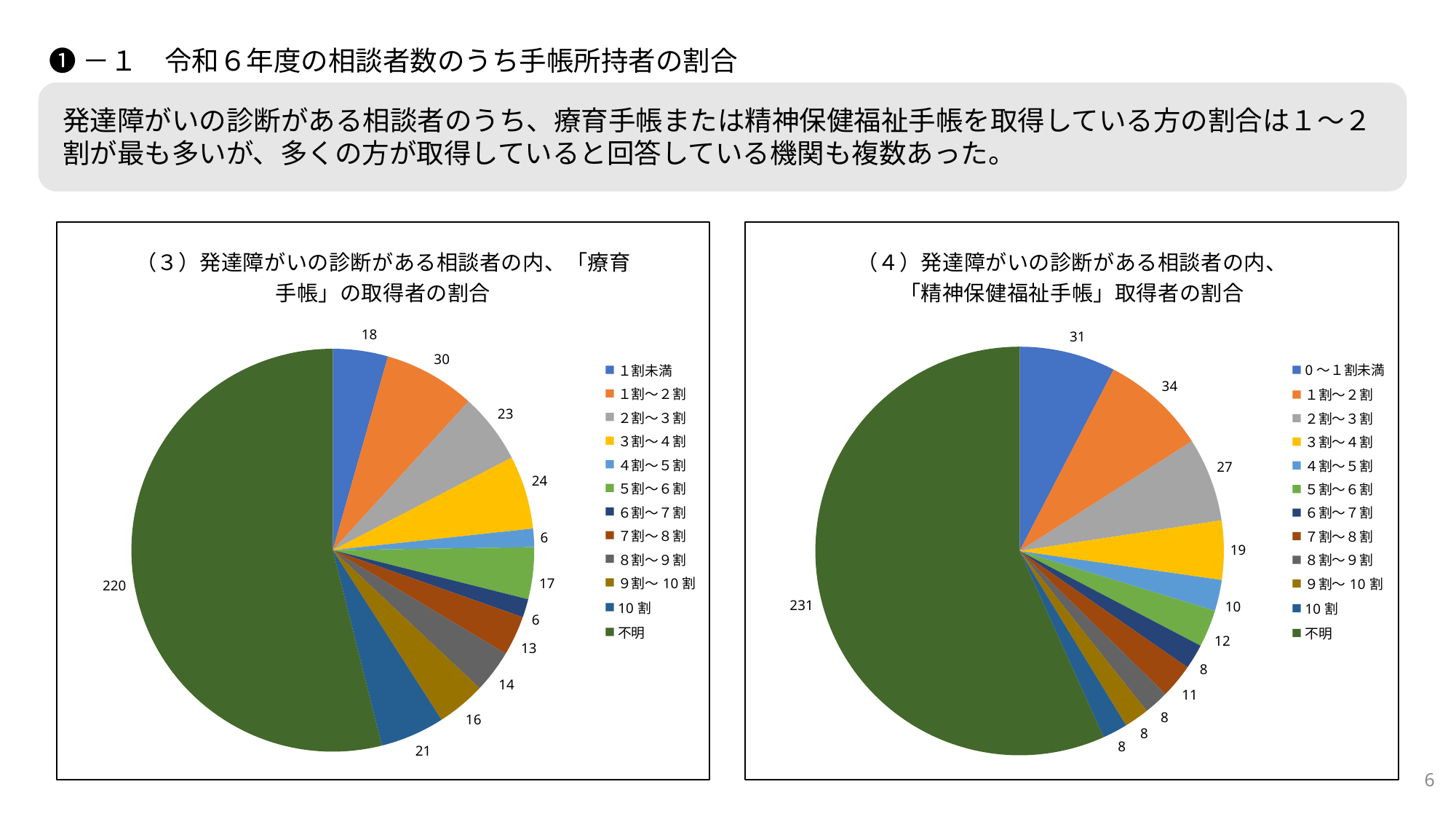
In the left chart (3) 「療育手帳」の取得者の割合, what is the value for 10割? 21 In the right chart (4) 「精神保健福祉手帳」取得者の割合, which is larger, the value for 1割〜2割 or the value for 3割〜4割? 1割〜2割 In the left chart (3) 「療育手帳」の取得者の割合, what is the difference between the values for 1割〜2割 and 1割未満? 12 In the left chart (3) 「療育手帳」の取得者の割合, what colour is the slice for 不明? Dark green In the right chart (4) 「精神保健福祉手帳」取得者の割合, what is the difference between the values for 0〜1割未満 and 4割〜5割? 21 In the right chart (4) 「精神保健福祉手帳」取得者の割合, what is the value for 不明? 231 In the left chart (3) 「療育手帳」の取得者の割合, what is the value for 1割〜2割? 30 In the right chart (4) 「精神保健福祉手帳」取得者の割合, which category has the largest slice? 不明 In the left chart (3) 「療育手帳」の取得者の割合, which category has the largest slice? 不明 In the right chart (4) 「精神保健福祉手帳」取得者の割合, what is the value for 2割〜3割? 27 What kind of chart is the right chart (4) 「精神保健福祉手帳」取得者の割合? Pie chart How many categories does the legend of the left chart (3) 「療育手帳」の取得者の割合 list? 12